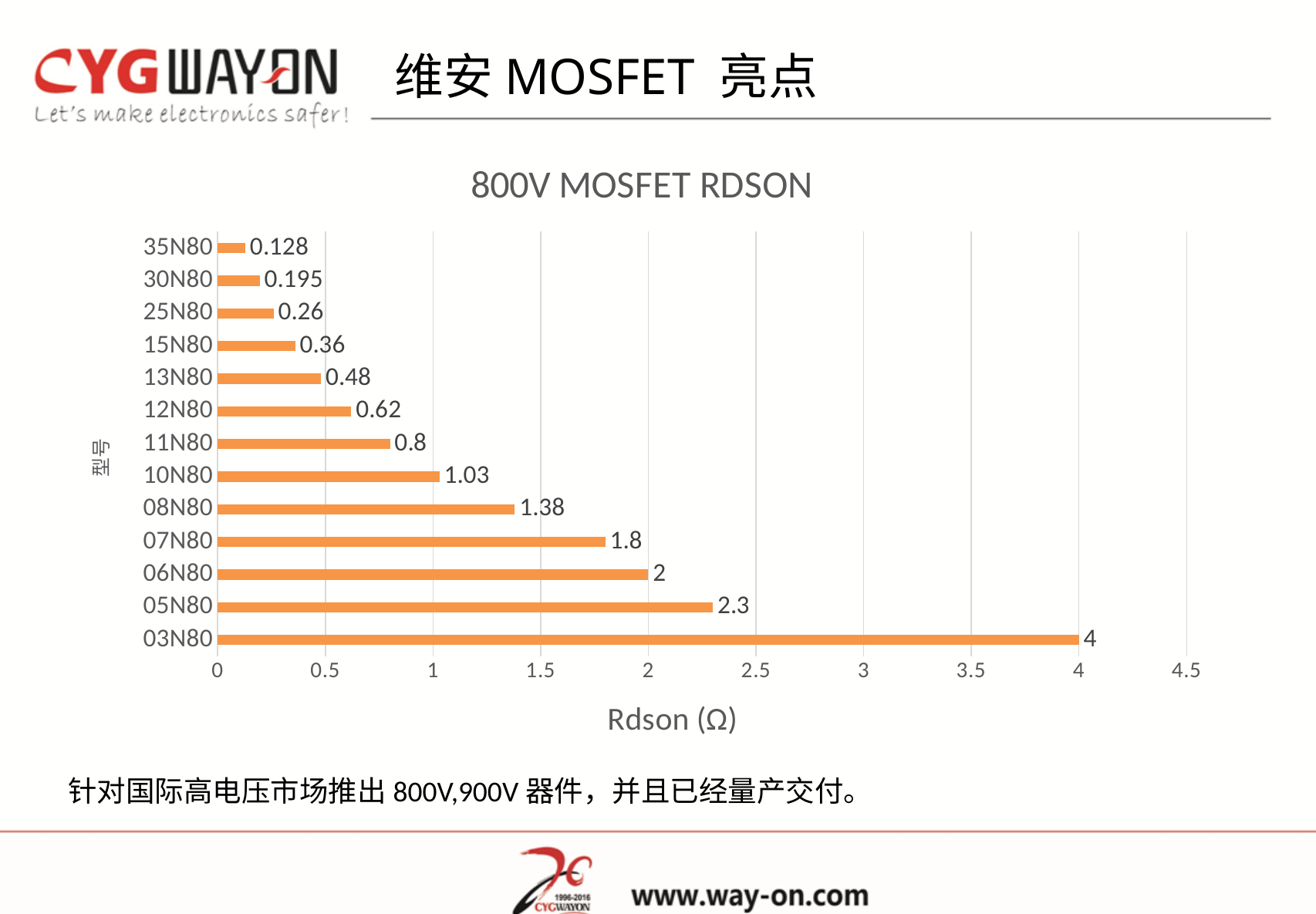
What is the title of the chart? 800V MOSFET RDSON Is the Rdson value for 08N80 greater or less than 1.5? less Which has a larger Rdson, 12N80 or 13N80? 12N80 What is the Rdson value for 35N80? 0.128 What is the Rdson value for 10N80? 1.03 Which model has the lowest Rdson? 35N80 What is the label of the horizontal axis? Rdson (Ω) Which model has the highest Rdson? 03N80 What is the difference in Rdson between 03N80 and 05N80? 1.7 What kind of chart is shown on the slide? Bar chart What is the Rdson value for 07N80? 1.8 How many models are shown in the chart? 13